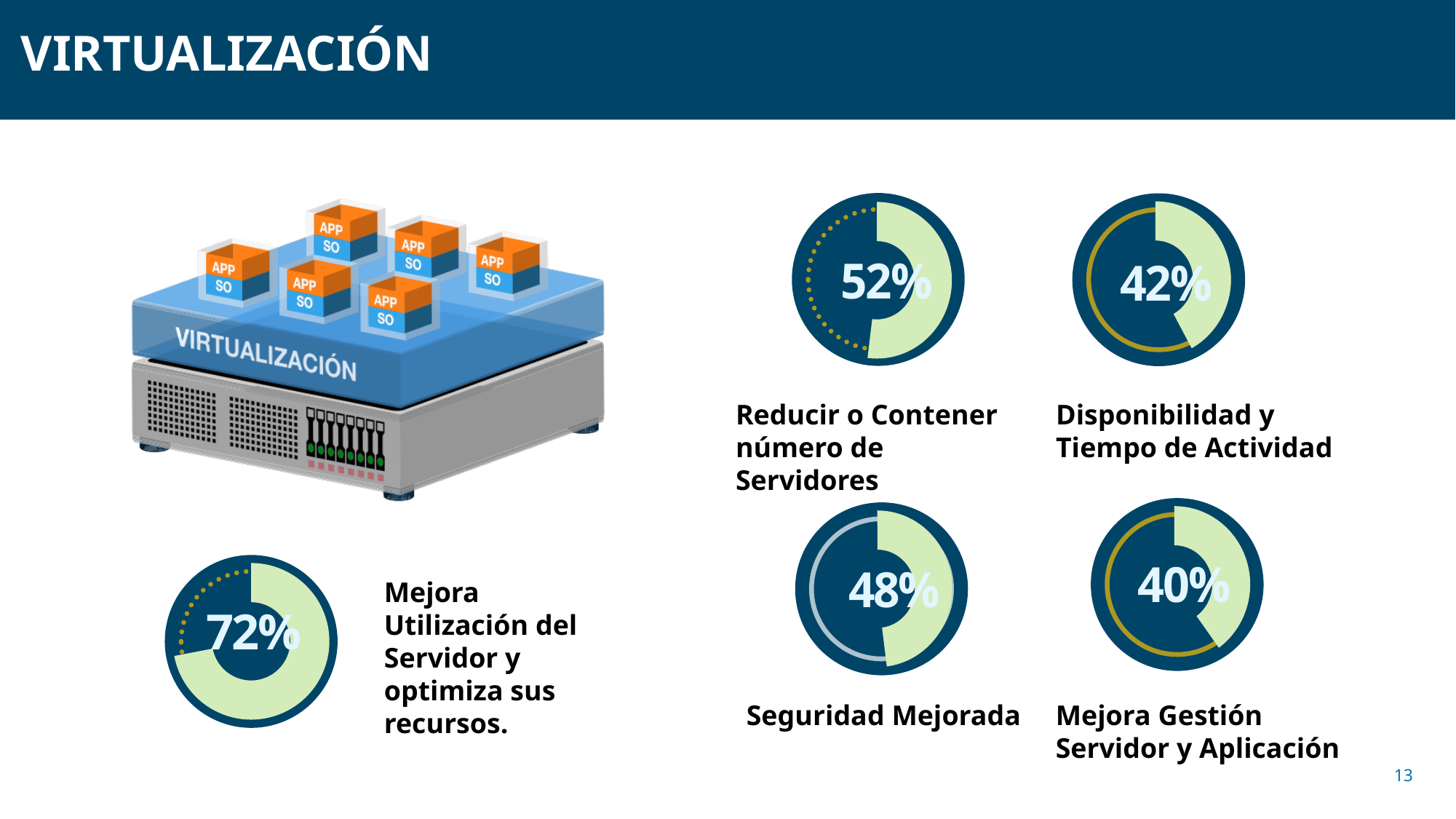
How many donut charts are shown on the slide? 5 Which is larger: the percentage for "Disponibilidad y Tiempo de Actividad" or the percentage for "Mejora Gestión Servidor y Aplicación"? Disponibilidad y Tiempo de Actividad Which of the donut charts on the slide shows the lowest percentage? Mejora Gestión Servidor y Aplicación (40%) What percentage is shown in the donut chart labelled "Mejora Utilización del Servidor y optimiza sus recursos"? 72% What is the difference between the percentage for "Reducir o Contener número de Servidores" and the percentage for "Seguridad Mejorada"? 4% What percentage is shown in the donut chart labelled "Seguridad Mejorada"? 48% What is the difference between the highest and lowest percentages shown in the donut charts? 32% What percentage is shown in the donut chart labelled "Disponibilidad y Tiempo de Actividad"? 42% What kind of chart is used to display the percentages on the slide? Donut (pie) chart Which of the donut charts on the slide shows the highest percentage? Mejora Utilización del Servidor y optimiza sus recursos (72%) What percentage is shown in the donut chart labelled "Reducir o Contener número de Servidores"? 52% What percentage is shown in the donut chart labelled "Mejora Gestión Servidor y Aplicación"? 40%